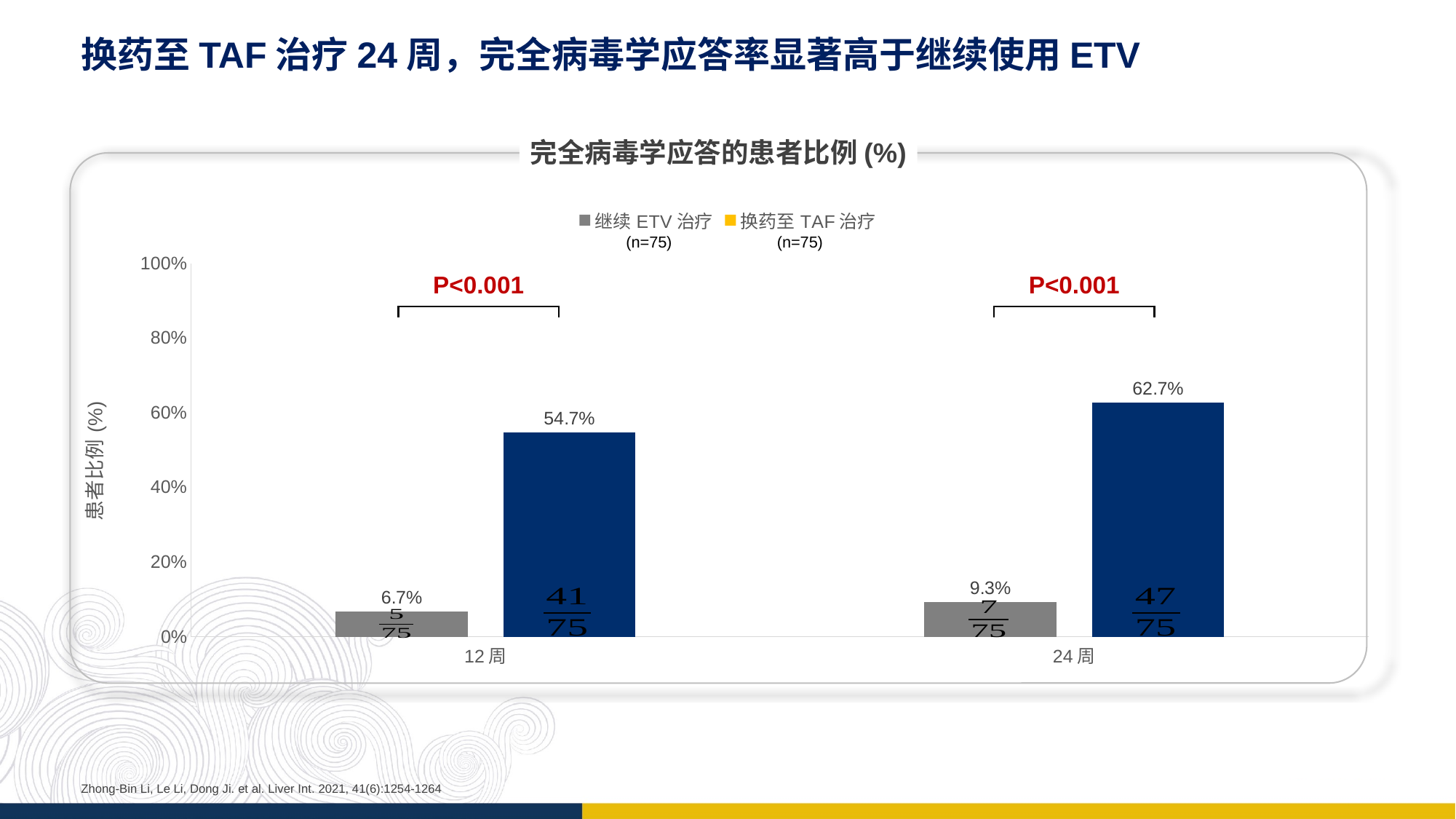
At 12 周, which series has the larger value, 继续 ETV 治疗 or 换药至 TAF 治疗? 换药至 TAF 治疗 What is the value for 继续 ETV 治疗 at 12 周? 6.7% What is the value for 继续 ETV 治疗 at 24 周? 9.3% What is the value for 换药至 TAF 治疗 at 12 周? 54.7% How many series does the legend list? 2 What kind of chart is shown on the slide? Bar chart Which bar has the lowest value on the chart? 继续 ETV 治疗 at 12 周 Does the value for 换药至 TAF 治疗 rise or fall from 12 周 to 24 周? Rise What is the difference between 换药至 TAF 治疗 and 继续 ETV 治疗 at 24 周? 53.4% Which bar has the highest value on the chart? 换药至 TAF 治疗 at 24 周 How many time-point categories are shown on the x axis? 2 What is the value for 换药至 TAF 治疗 at 24 周? 62.7%